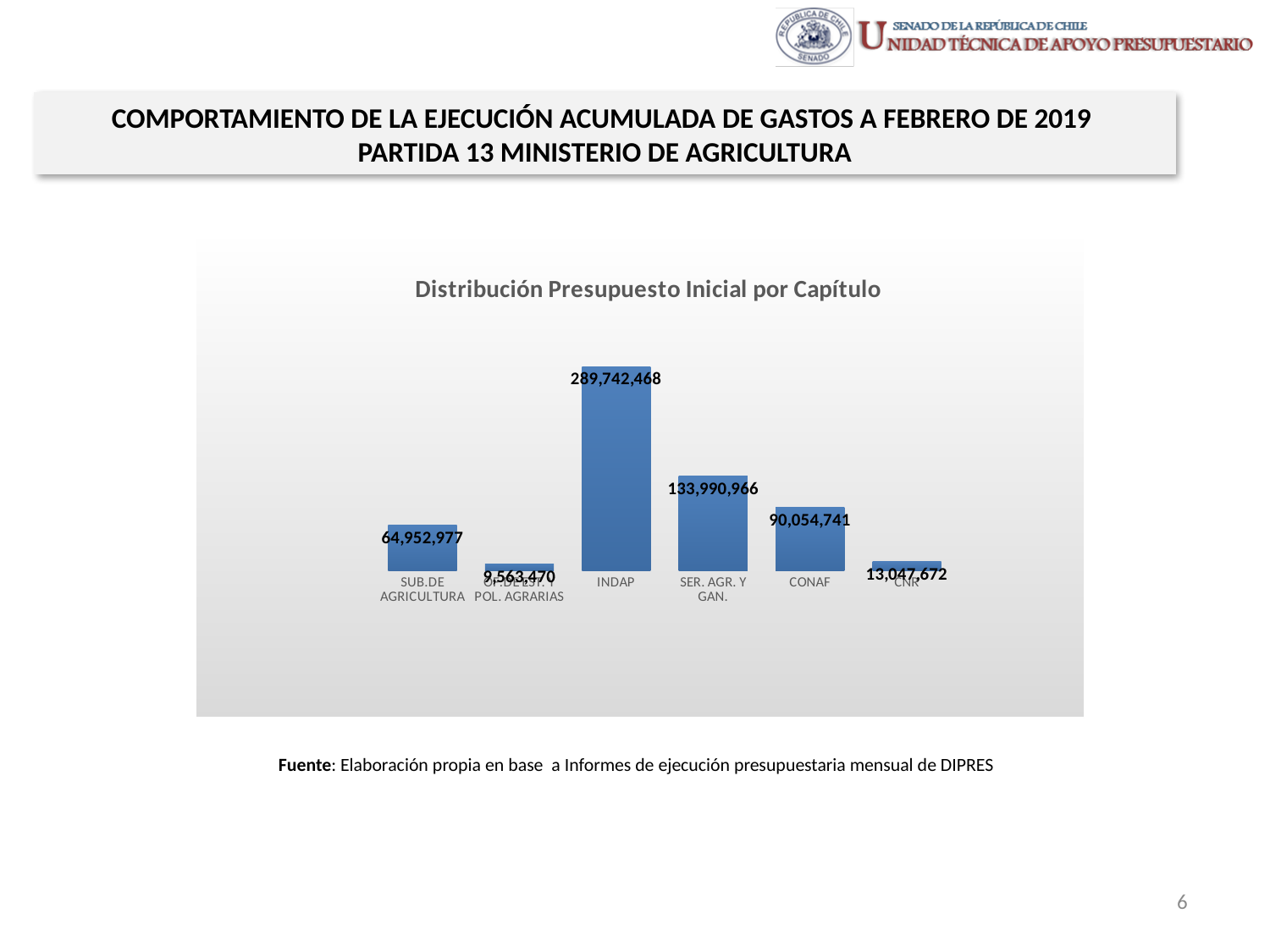
Which category has the lowest value in the chart? OF.DE EST. Y POL. AGRARIAS What type of chart is shown on the slide? Bar chart What is the value for SER. AGR. Y GAN. in the chart? 133,990,966 What is the value for INDAP in the Distribución Presupuesto Inicial por Capítulo chart? 289,742,468 What is the value for CNR in the chart? 13,047,672 What is the value for SUB.DE AGRICULTURA in the chart? 64,952,977 How many categories are shown in the chart? 6 What is the difference between the values for CONAF and SUB.DE AGRICULTURA? 25,101,764 Which category has the highest value in the chart? INDAP What is the value for CONAF in the chart? 90,054,741 Which is larger, the value for CONAF or the value for SUB.DE AGRICULTURA? CONAF What is the difference between the values for INDAP and SER. AGR. Y GAN.? 155,751,502